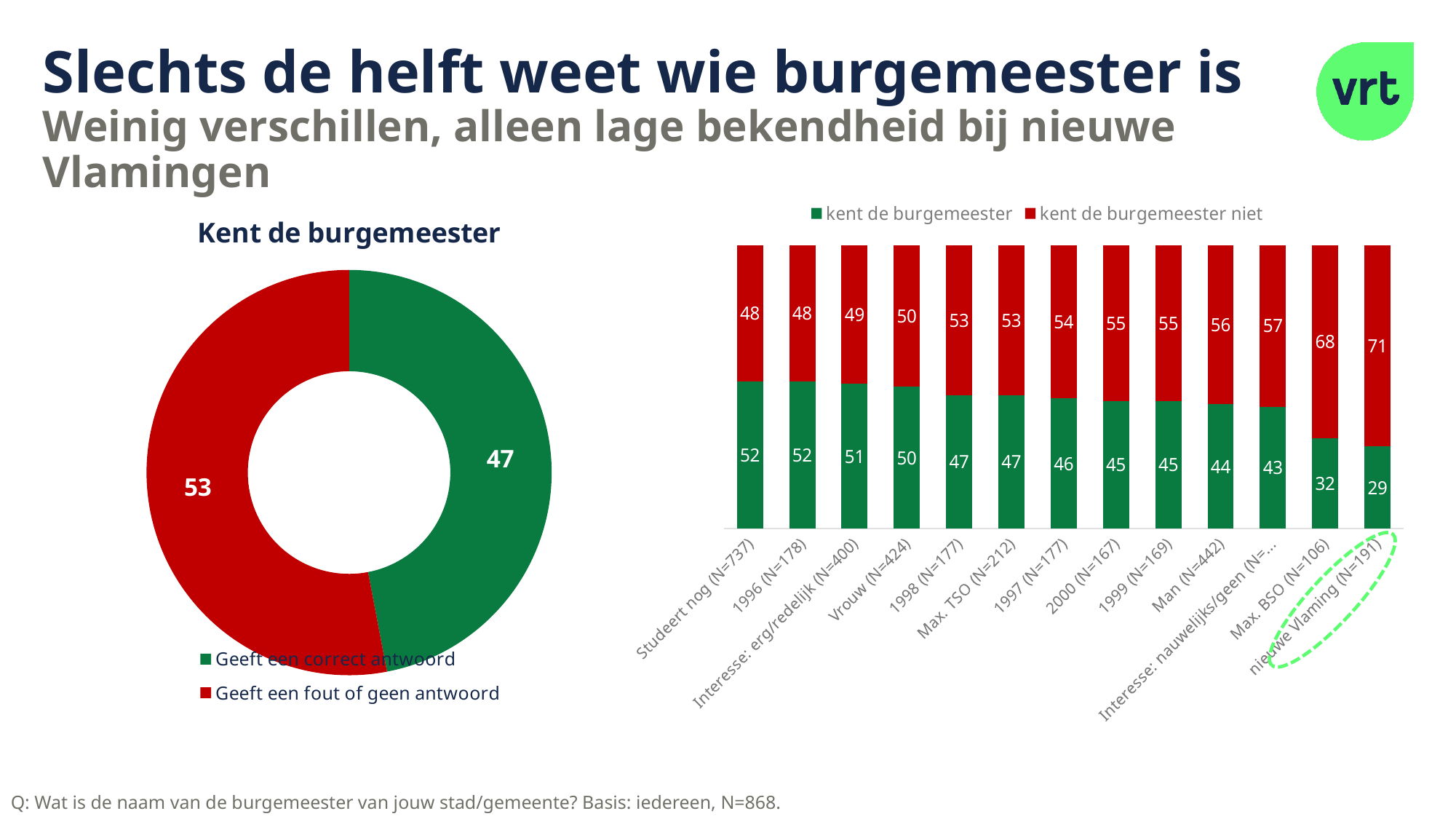
How many categories are shown on the x axis of the stacked bar chart on the right? 13 In the donut chart 'Kent de burgemeester', what value is shown for 'Geeft een correct antwoord'? 47 In the stacked bar chart on the right, which category has the highest value for 'kent de burgemeester niet'? nieuwe Vlaming (N=191) In the donut chart 'Kent de burgemeester', what value is shown for 'Geeft een fout of geen antwoord'? 53 How many series does the legend of the stacked bar chart on the right list? 2 In the stacked bar chart on the right, what is the value of 'kent de burgemeester' for 'nieuwe Vlaming (N=191)'? 29 In the stacked bar chart on the right, what is the total of the stacked bar for 'Vrouw (N=424)'? 100 What kind of chart is the chart on the left titled 'Kent de burgemeester'? Donut (pie) chart In the stacked bar chart on the right, which category has the lowest value for 'kent de burgemeester'? nieuwe Vlaming (N=191) In the stacked bar chart on the right, what is the difference between the 'kent de burgemeester' values for 'Studeert nog (N=737)' and 'Max. BSO (N=106)'? 20 In the stacked bar chart on the right, what is the value of 'kent de burgemeester niet' for 'Max. BSO (N=106)'? 68 In the donut chart 'Kent de burgemeester', which slice is larger: 'Geeft een correct antwoord' or 'Geeft een fout of geen antwoord'? Geeft een fout of geen antwoord